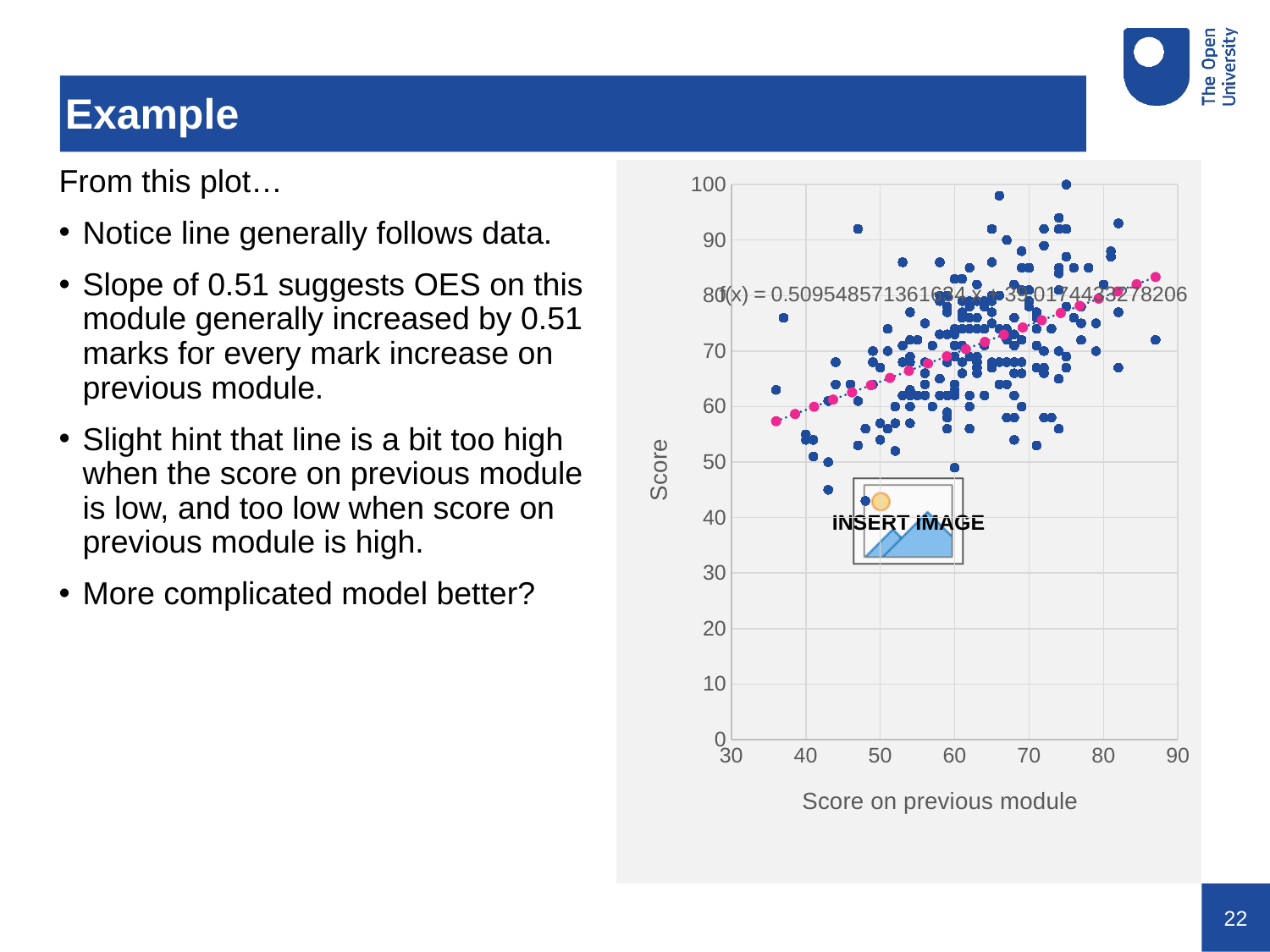
What kind of chart is shown on the slide? scatter chart Is the trend line's value at a previous-module score of 50 greater or less than 70? less What is the title of the x axis of the chart? Score on previous module What is the title of the y axis of the chart? Score Does the fitted trend line rise or fall as the score on previous module increases? rises Is the highest plotted point on the chart greater or less than 90 on the Score axis? greater Is the trend line's value at a previous-module score of 40 greater or less than 50? greater What is the lowest value shown on the x axis of the chart? 30